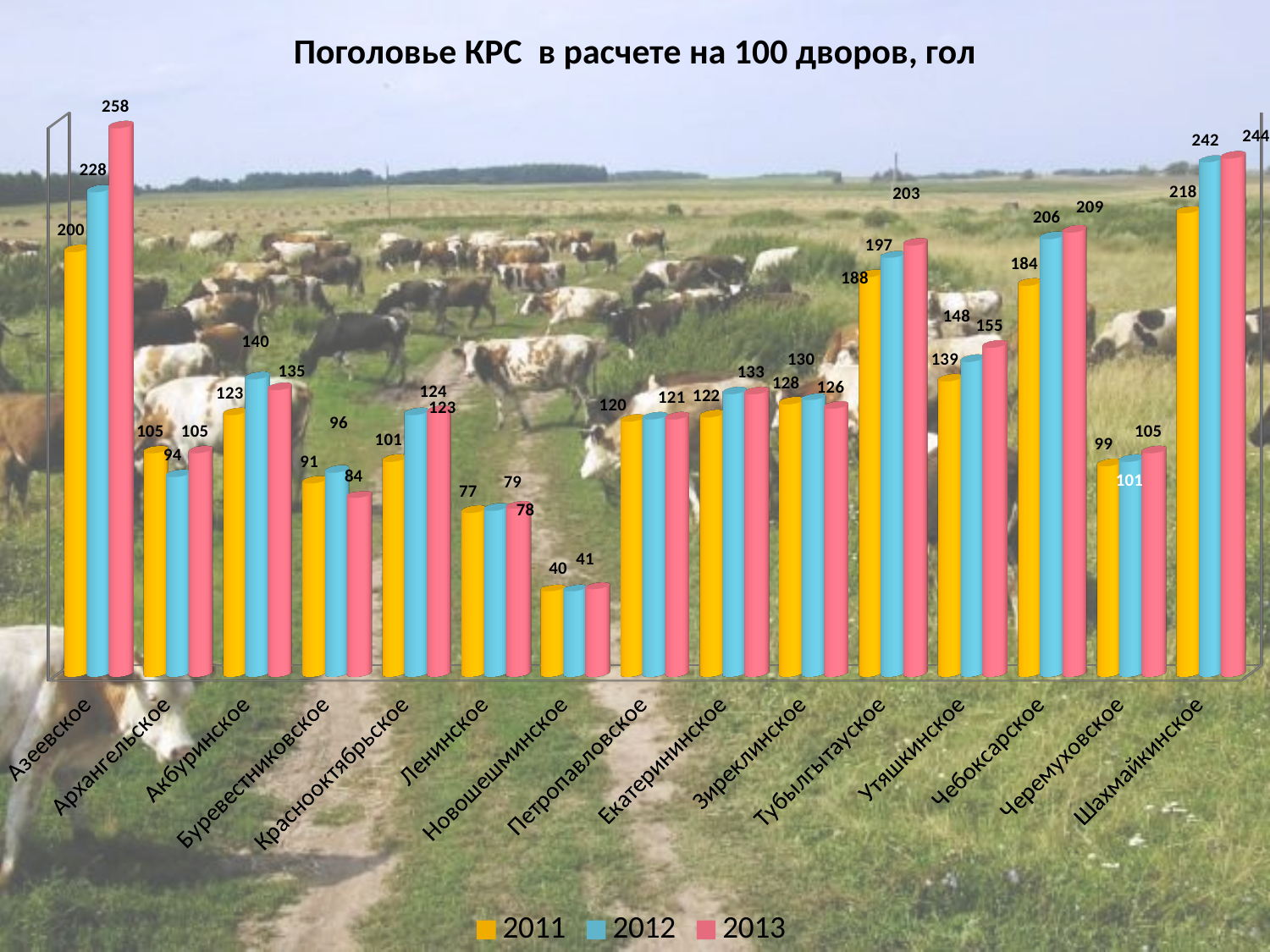
Do the values for Утяшкинское rise or fall from 2011 to 2013? rise How many series does the legend list? 3 What is the value for Азеевское in 2013? 258 Which is larger in 2013: Чебоксарское or Тубылгытауское? Чебоксарское What is the value for Шахмайкинское in 2011? 218 What kind of chart is shown on the slide? bar chart What is the value for Архангельское in 2012? 94 How many categories are shown on the x axis? 15 Which category has the lowest value in the 2011 series? Новошешминское What is the title of the chart? Поголовье КРС в расчете на 100 дворов, гол Which category has the highest value in the 2013 series? Азеевское What is the difference between the 2013 and 2011 values for Азеевское? 58